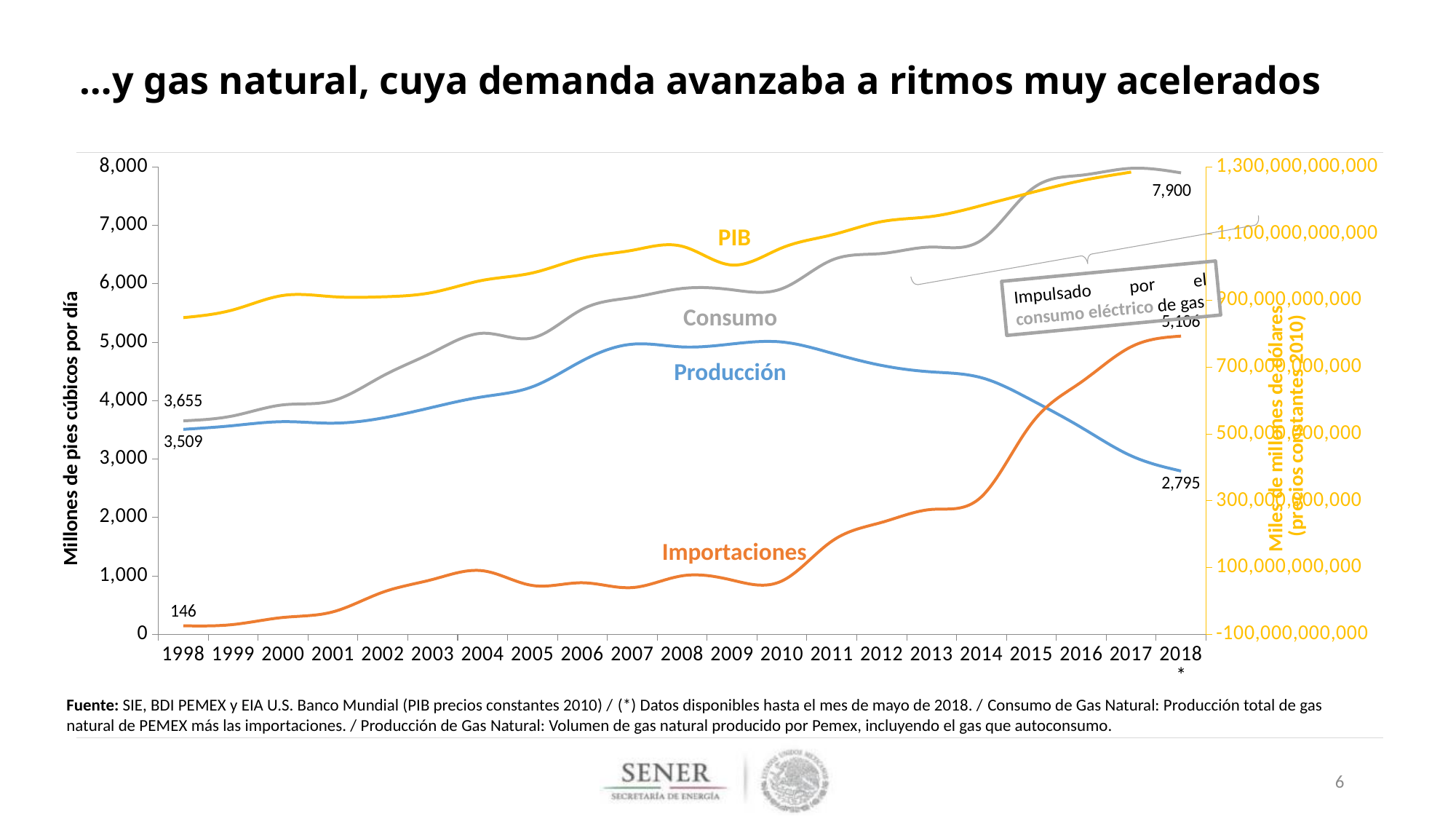
Is the value for Importaciones in 2004 greater or less than 2,000? less What is the value of Consumo in 1998? 3,655 What is the value of Importaciones in 1998? 146 Which series is plotted against the right-hand axis? PIB What is the value of Producción in 1998? 3,509 What kind of chart is shown on the slide? line chart Does the Producción line rise or fall between 2010 and 2018? fall Among Consumo, Producción and Importaciones, which series has the lowest value in 1998? Importaciones What is the value of Producción in 2018? 2,795 By how much did Consumo increase between 1998 and 2018? 4,245 What is the value of Consumo in 2018? 7,900 How many data series are plotted on the chart? 4